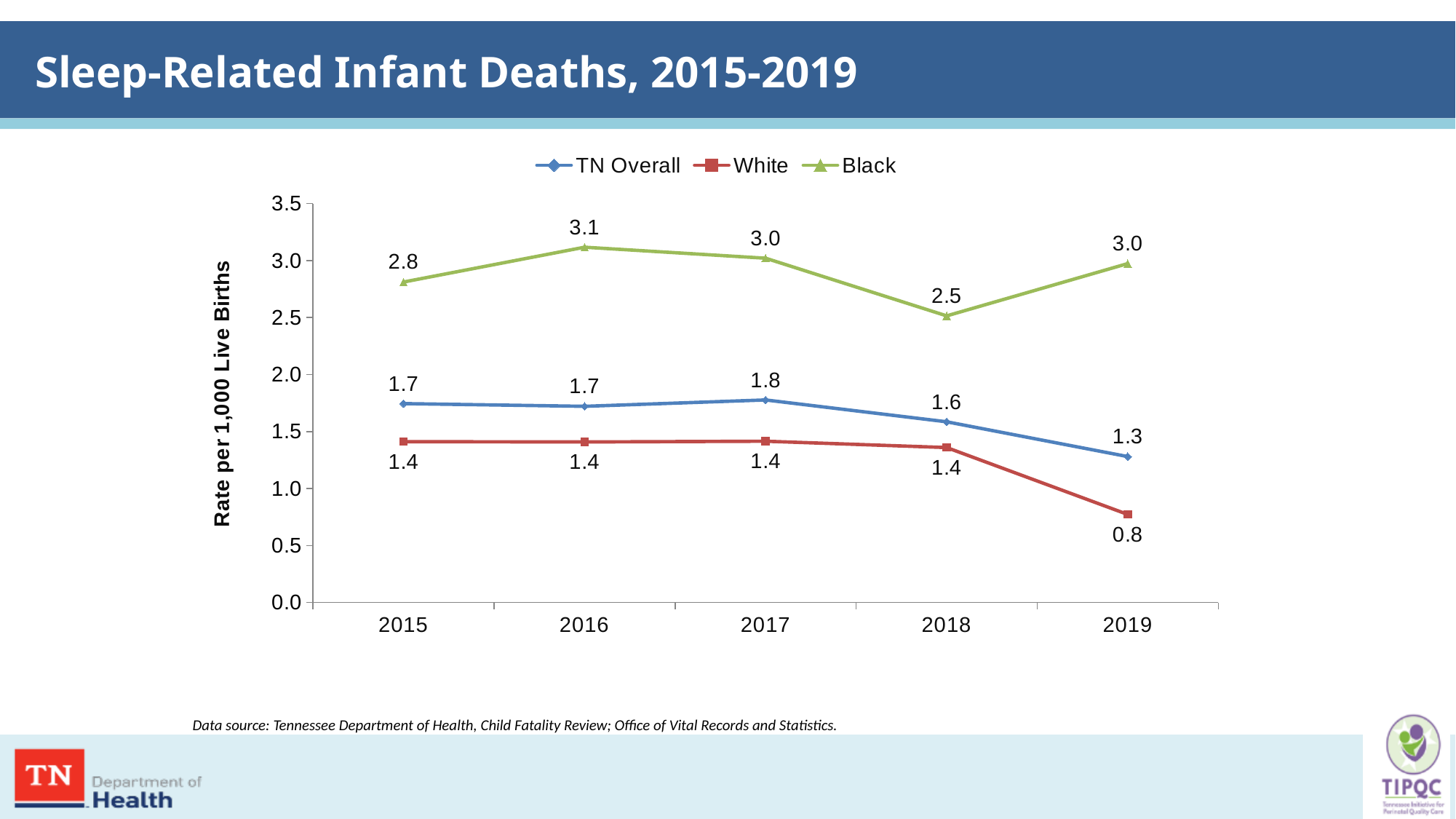
What is the rate for White in 2019? 0.8 Which is larger in 2018, the Black rate or the TN Overall rate? Black What is the TN Overall rate in 2017? 1.8 How many series does the legend list? 3 How many years are shown on the x axis? 5 What is the rate for Black in 2016? 3.1 Does the White rate rise or fall from 2018 to 2019? fall Is the Black rate in 2015 greater or less than 2.5? greater What is the difference between the Black rate and the White rate in 2019? 2.2 In which year is the Black rate lowest? 2018 What kind of chart is shown on the slide? line chart In which year is the TN Overall rate highest? 2017